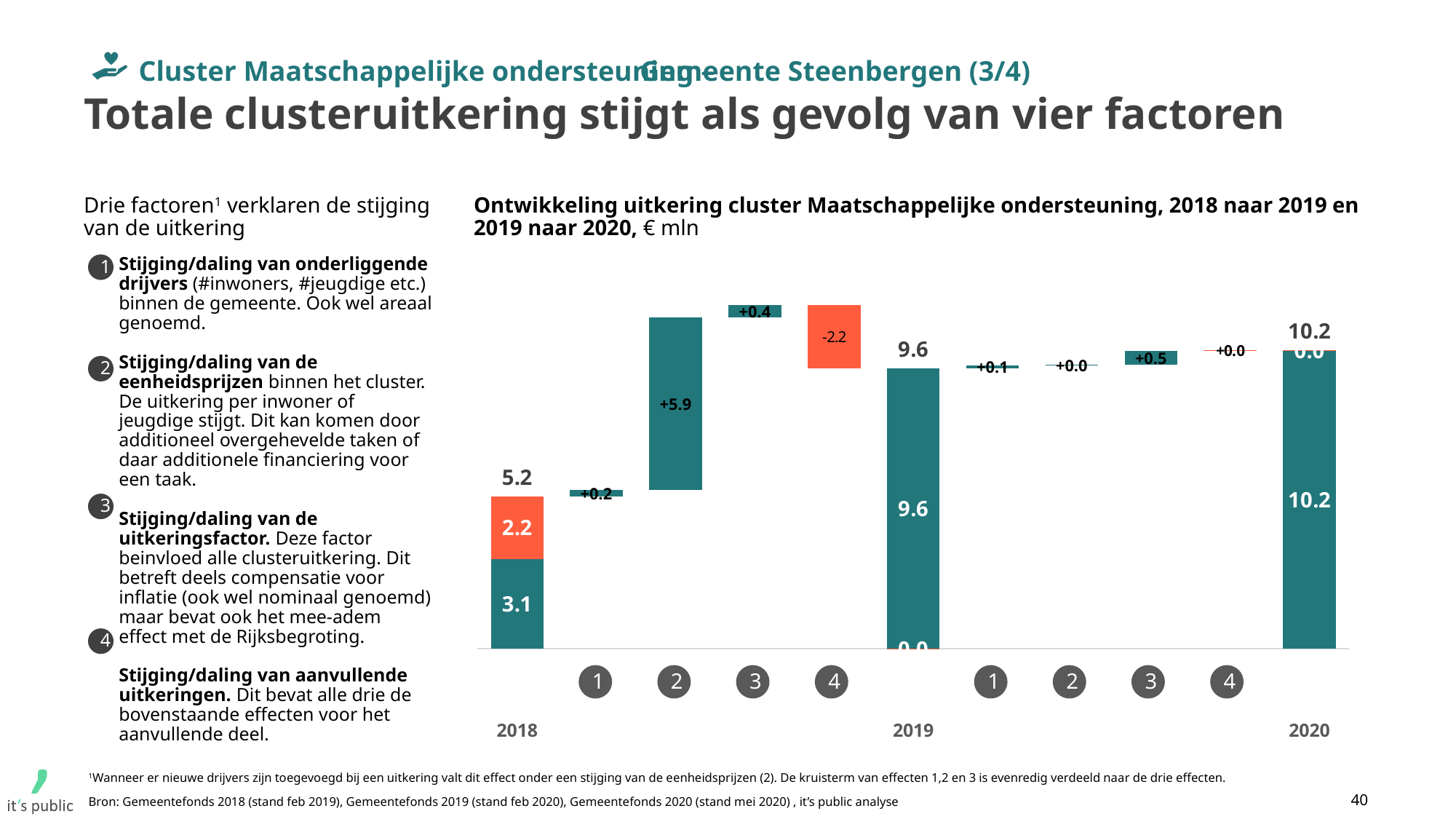
What is the total uitkering for 2020 shown in the chart? 10.2 What is the total uitkering for 2019 shown in the chart? 9.6 What is the value of factor 2 in the step from 2018 to 2019? +5.9 Which factor contributes the largest increase between 2018 and 2019? Factor 2 What is the value of factor 3 in the step from 2019 to 2020? +0.5 Which is larger, the 2019 total or the 2020 total? 2020 What is the difference between the 2020 total and the 2018 total? 5.0 What kind of chart is shown on the slide? bar chart (waterfall) Do the yearly totals rise or fall from 2018 to 2020? rise In what unit are the values in the chart expressed? € mln What is the value of factor 4 in the step from 2018 to 2019? -2.2 What is the total uitkering for 2018 shown in the chart? 5.2